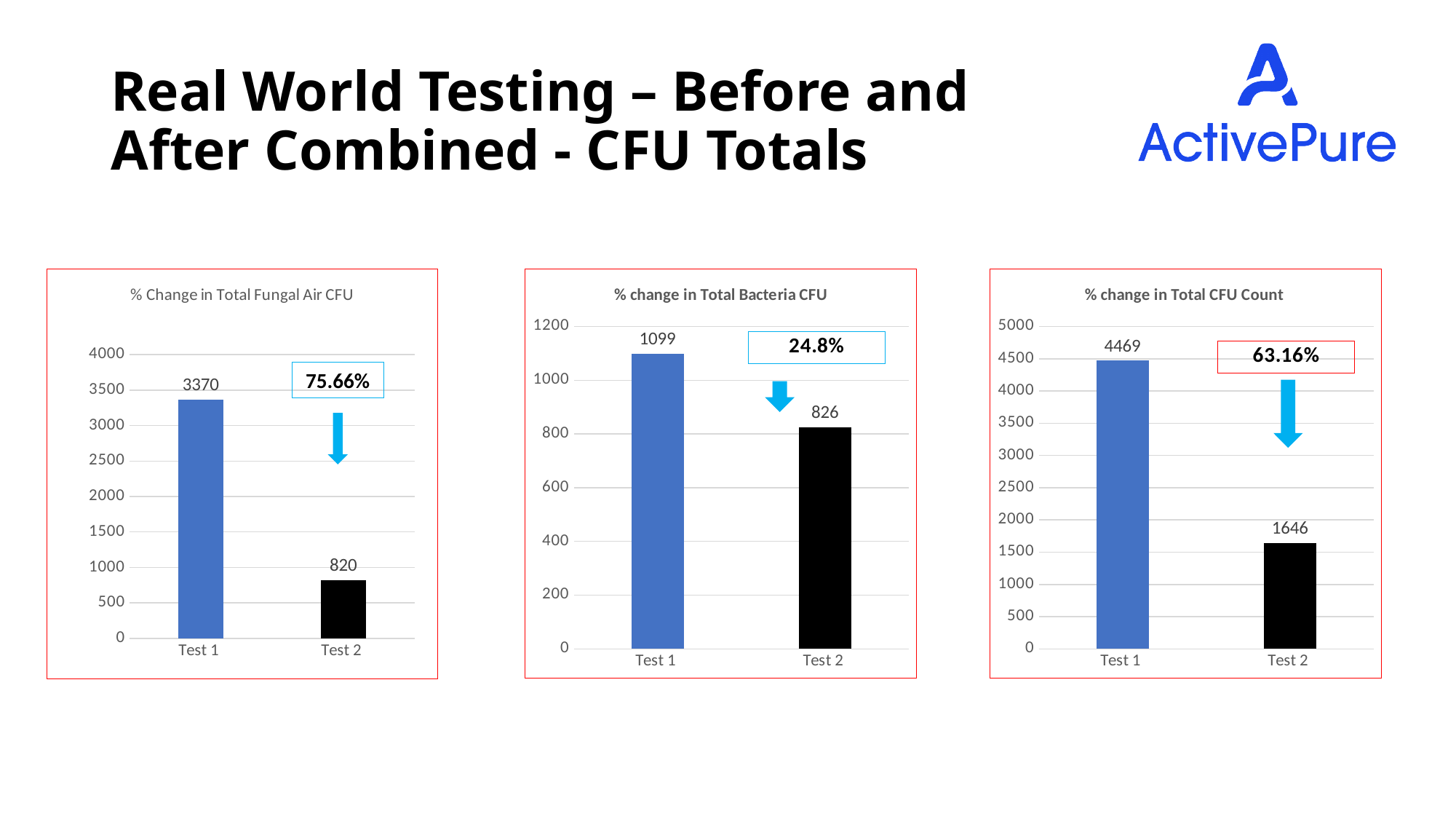
In the '% change in Total CFU Count' chart, what is the difference between Test 1 and Test 2? 2823 What percentage change is shown in the box on the '% change in Total CFU Count' chart? 63.16% In the '% change in Total Bacteria CFU' chart, what is the value for Test 2? 826 In the '% change in Total CFU Count' chart, which category has the lowest value? Test 2 How many categories are shown in the '% Change in Total Fungal Air CFU' chart? 2 In the '% Change in Total Fungal Air CFU' chart, what is the difference between Test 1 and Test 2? 2550 In the '% change in Total Bacteria CFU' chart, what is the value for Test 1? 1099 What kind of chart is the '% change in Total Bacteria CFU' chart? Bar chart In the '% change in Total Bacteria CFU' chart, which test has the higher value? Test 1 In the '% Change in Total Fungal Air CFU' chart, what is the value for Test 2? 820 In the '% change in Total CFU Count' chart, what is the value for Test 2? 1646 In the '% Change in Total Fungal Air CFU' chart, what is the value for Test 1? 3370